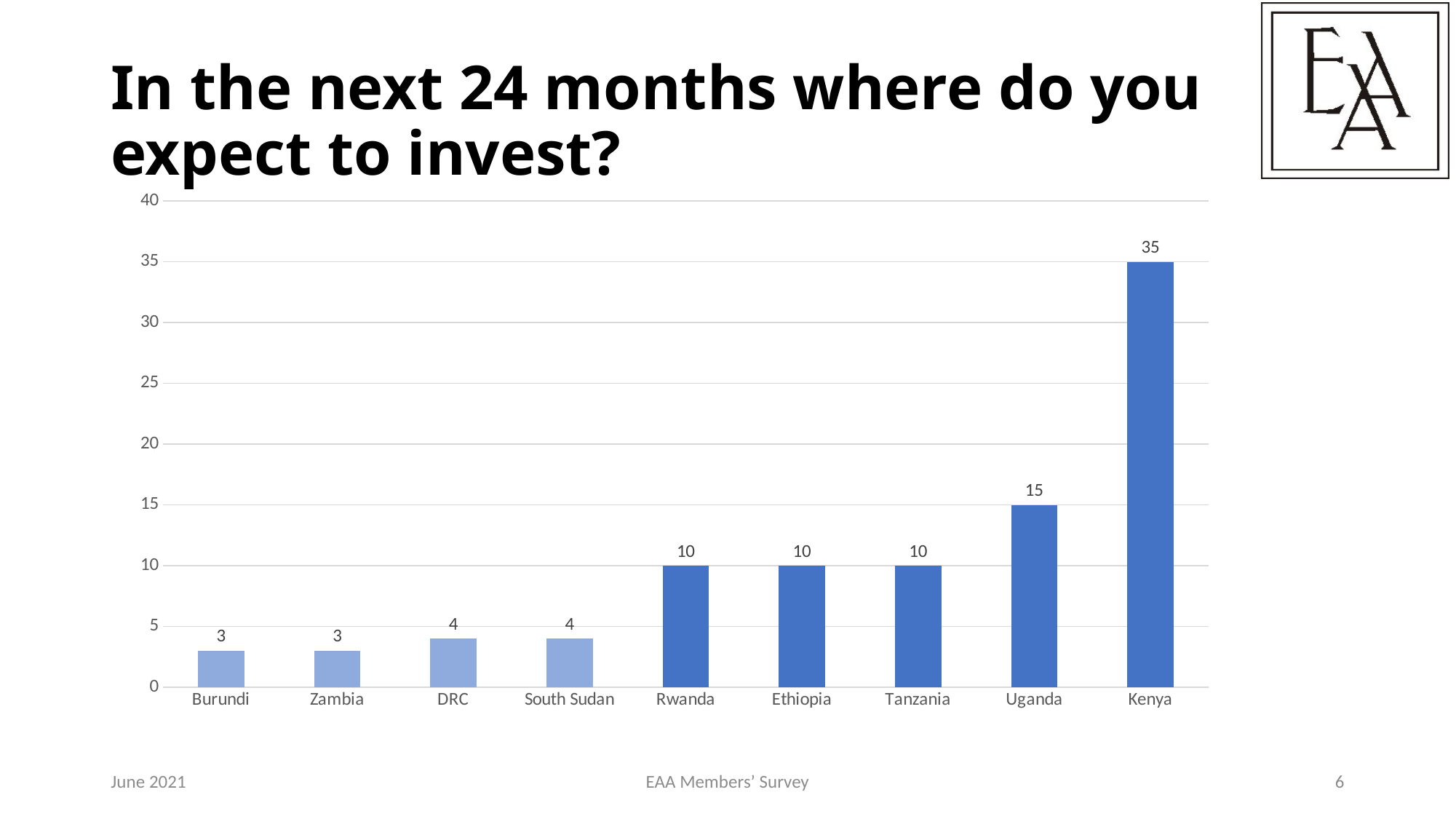
What kind of chart is shown on the slide? bar chart What is the value for Kenya? 35 What is the difference between the values for Rwanda and Zambia? 7 What is the value for Burundi? 3 How many countries are shown on the chart? 9 What is the difference between the values for Kenya and Uganda? 20 Which country has the highest value? Kenya Is the value for Kenya greater or less than 30? greater Which is larger, the value for Uganda or the value for Tanzania? Uganda Do the values rise or fall from left to right along the x axis? rise What is the value for Uganda? 15 What is the value for DRC? 4